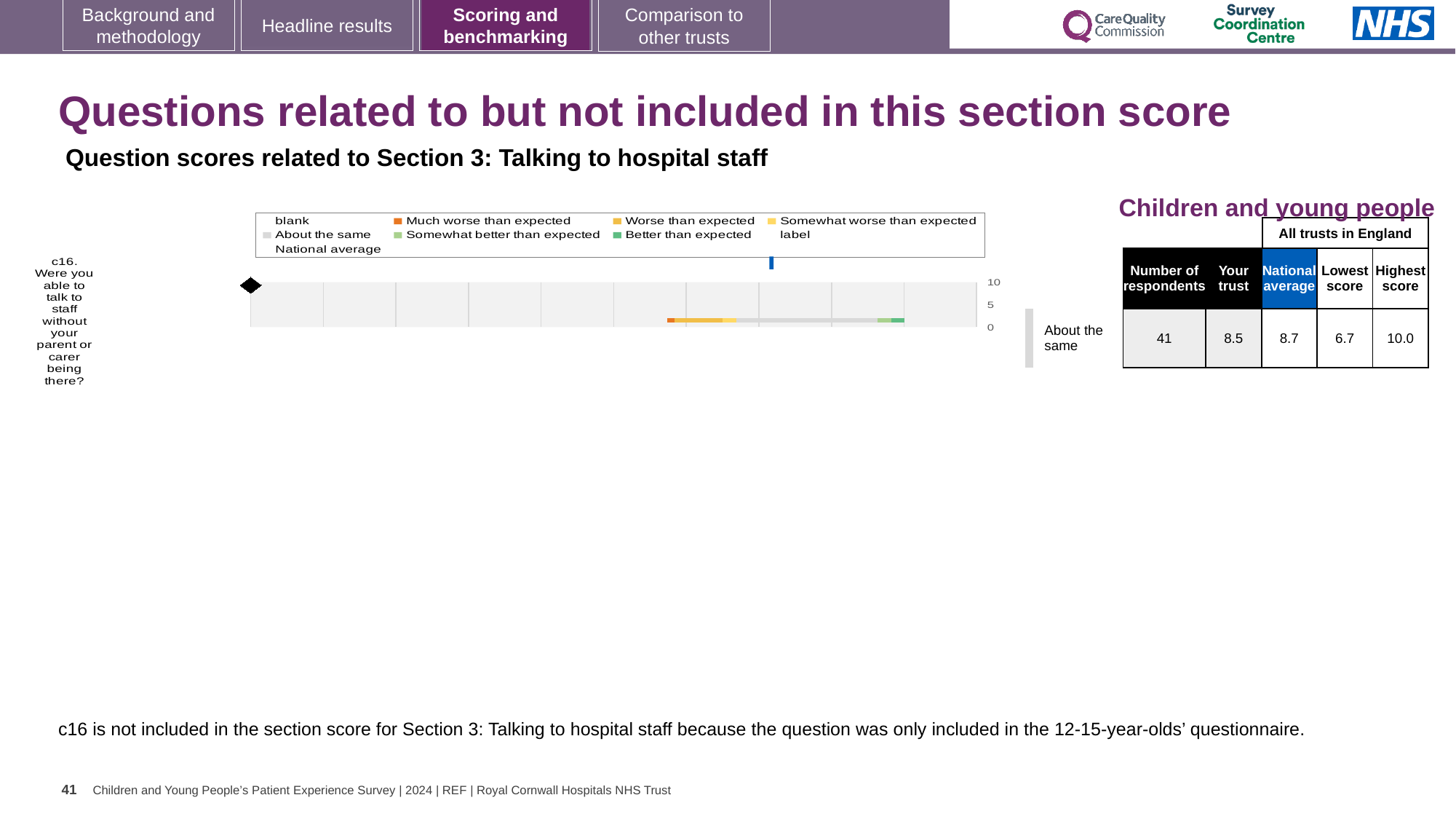
How many question categories are plotted on the chart? 1 In the table beside the chart, which is larger for c16: the 'Your trust' score or the National average? National average What benchmark category is shown next to the chart for question c16? About the same In the table beside the chart, how many respondents answered c16? 41 What is the highest value shown on the chart's axis? 10 In the table beside the chart, what is the Lowest score across all trusts in England for c16? 6.7 Which legend entry is shown in orange on the chart? Much worse than expected What kind of chart is shown on the slide for question c16? bar chart In the table beside the chart, what is the 'Your trust' score for c16? 8.5 How many entries does the chart legend list? 9 In the table beside the chart, what is the National average score for c16? 8.7 In the table beside the chart, what is the difference between the Highest score and the Lowest score for c16? 3.3